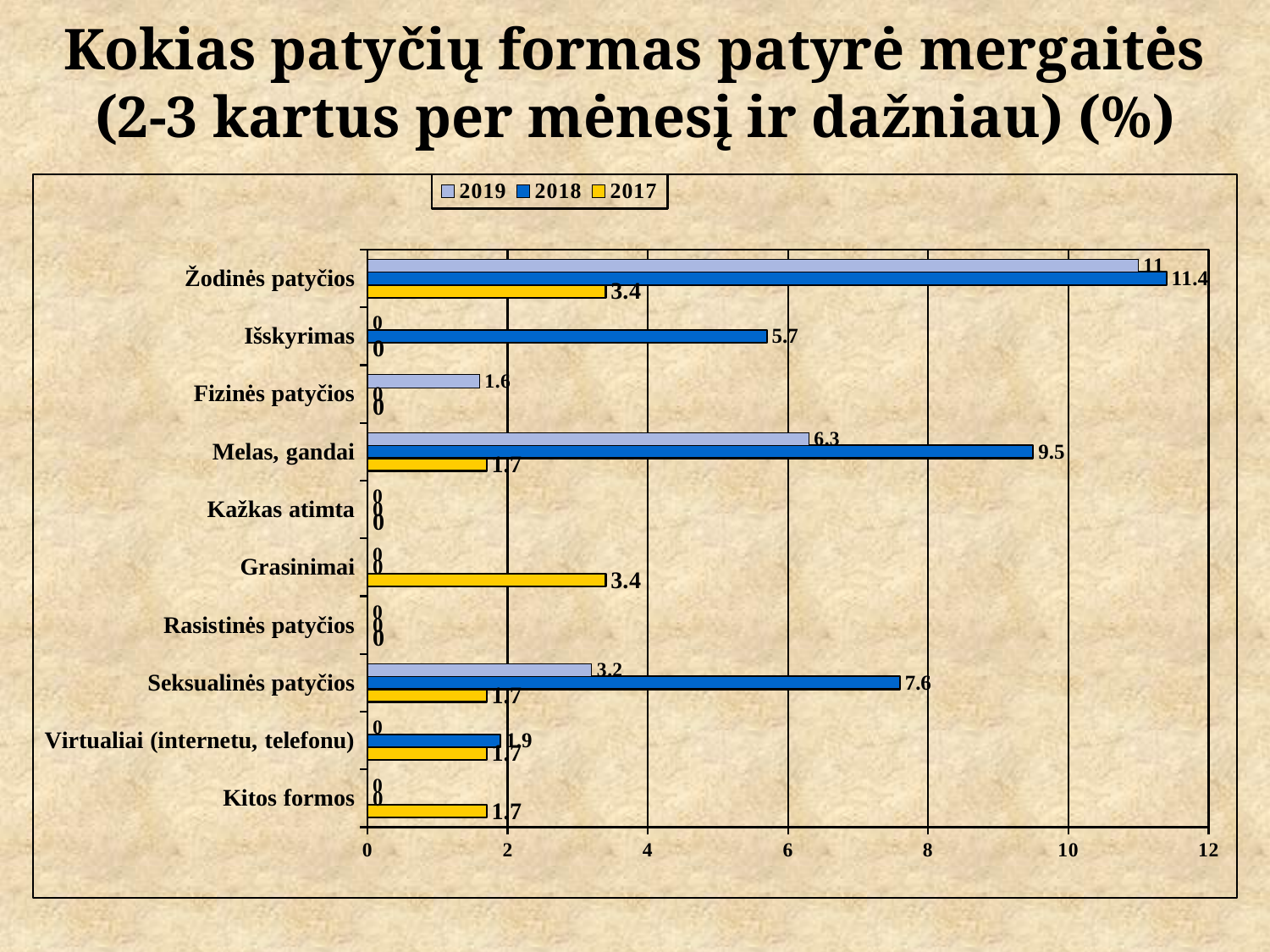
Which category has the highest 2017 value? Žodinės patyčios and Grasinimai (tied at 3.4) What is the difference between the 2018 and 2019 values for Melas, gandai? 3.2 How many series does the legend list? 3 What is the difference between the 2018 and 2017 values for Žodinės patyčios? 8 What is the 2018 value for Seksualinės patyčios? 7.6 Which is larger for Seksualinės patyčios: the 2019 value or the 2018 value? 2018 How many categories are shown on the chart? 10 What is the 2017 value for Grasinimai? 3.4 What is the 2019 value for Melas, gandai? 6.3 Which category has the highest 2018 value? Žodinės patyčios What is the 2018 value for Žodinės patyčios? 11.4 What kind of chart is shown on the slide? Bar chart